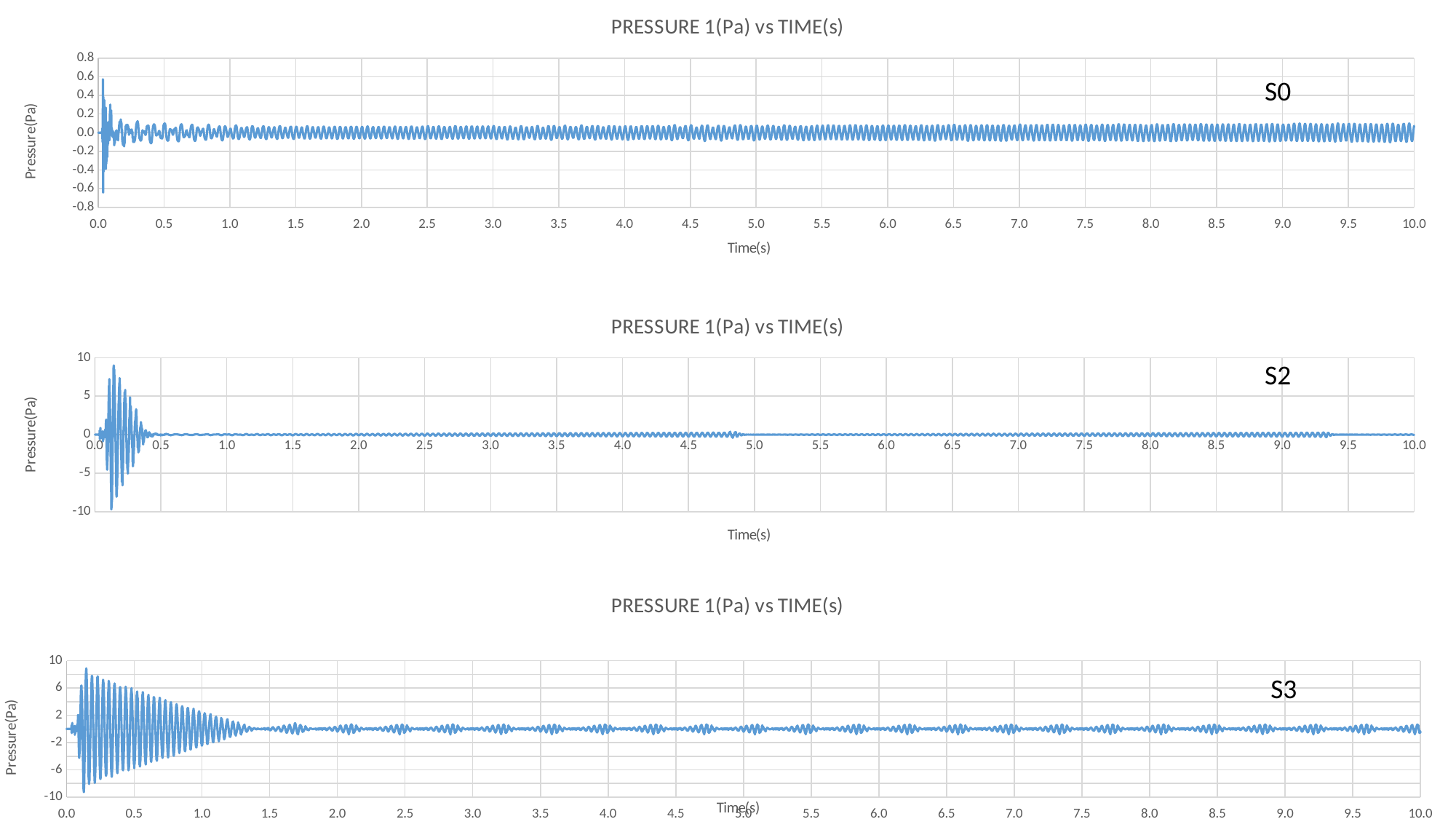
In the top chart labelled S0, is the highest pressure value reached greater or less than 0.4? greater What is the title of the middle chart labelled S2? PRESSURE 1(Pa) vs TIME(s) What is the y-axis title of the bottom chart labelled S3? Pressure(Pa) In the bottom chart labelled S3, does the amplitude of the pressure oscillation rise or fall as time increases from 0.0 to 1.5 s? fall In the bottom chart labelled S3, is the lowest pressure value reached greater or less than -6? less In the middle chart labelled S2, is the highest pressure value reached greater or less than 5? greater How many charts are shown on the slide? 3 What kind of chart is the top chart labelled S0? line chart What is the maximum value shown on the x axis of the bottom chart labelled S3? 10.0 Which chart reaches a larger peak pressure, the top chart labelled S0 or the middle chart labelled S2? S2